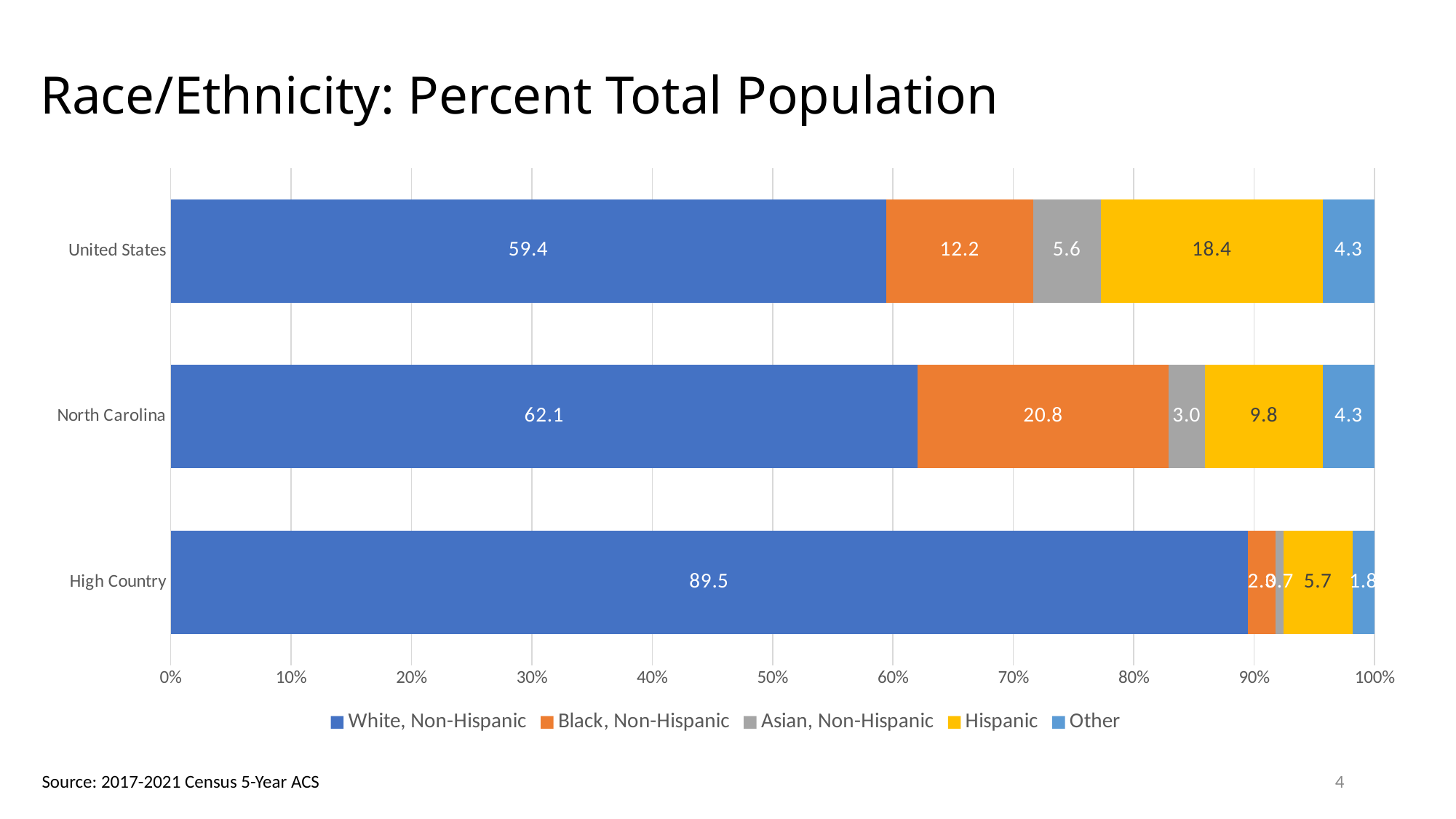
How many series does the legend list? 5 What is the title of the chart? Race/Ethnicity: Percent Total Population Which is larger: the Black, Non-Hispanic value for North Carolina or for the United States? North Carolina How many categories (regions) are plotted on the chart? 3 What is the difference between the Hispanic values for the United States and North Carolina? 8.6 What is the Hispanic value for the United States? 18.4 Which region has the highest White, Non-Hispanic value? High Country What kind of chart is shown on the slide? Stacked bar chart What is the Asian, Non-Hispanic value for the United States? 5.6 What is the Black, Non-Hispanic value for North Carolina? 20.8 What is the White, Non-Hispanic value for High Country? 89.5 Which region has the lowest Hispanic value? High Country